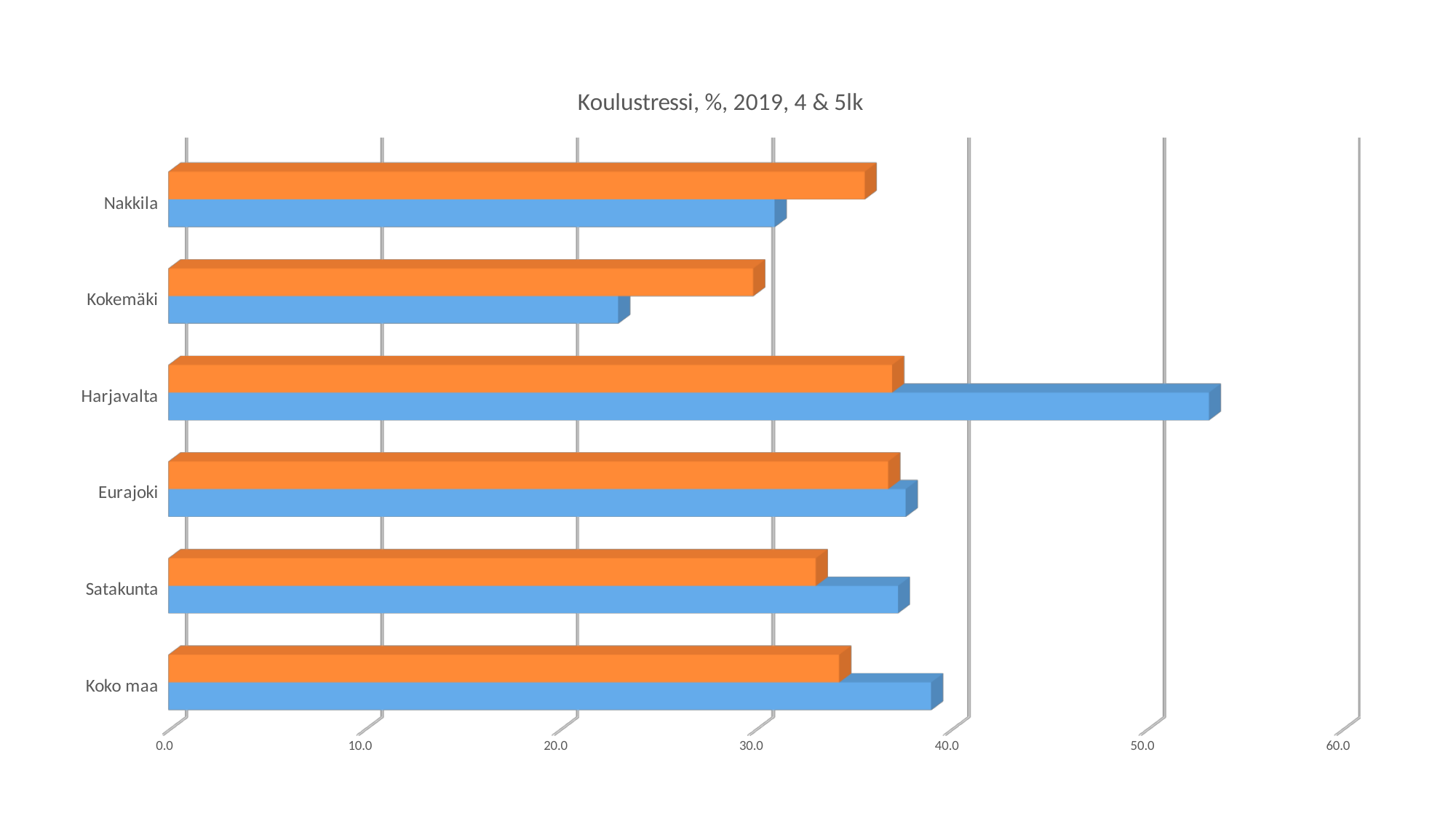
How many categories are shown on the vertical axis of the chart? 6 Which category has the shortest blue bar? Kokemäki What kind of chart is shown on the slide? bar chart For Harjavalta, which bar is longer, the orange one or the blue one? the blue one Is the blue bar for Satakunta greater or less than 40.0? less What is the title of the chart? Koulustressi, %, 2019, 4 & 5lk For Nakkila, which bar is longer, the orange one or the blue one? the orange one Is the orange bar for Nakkila greater or less than 30.0? greater Is the blue bar for Kokemäki greater or less than 30.0? less Which category has the longest blue bar? Harjavalta Which category has the shortest orange bar? Kokemäki